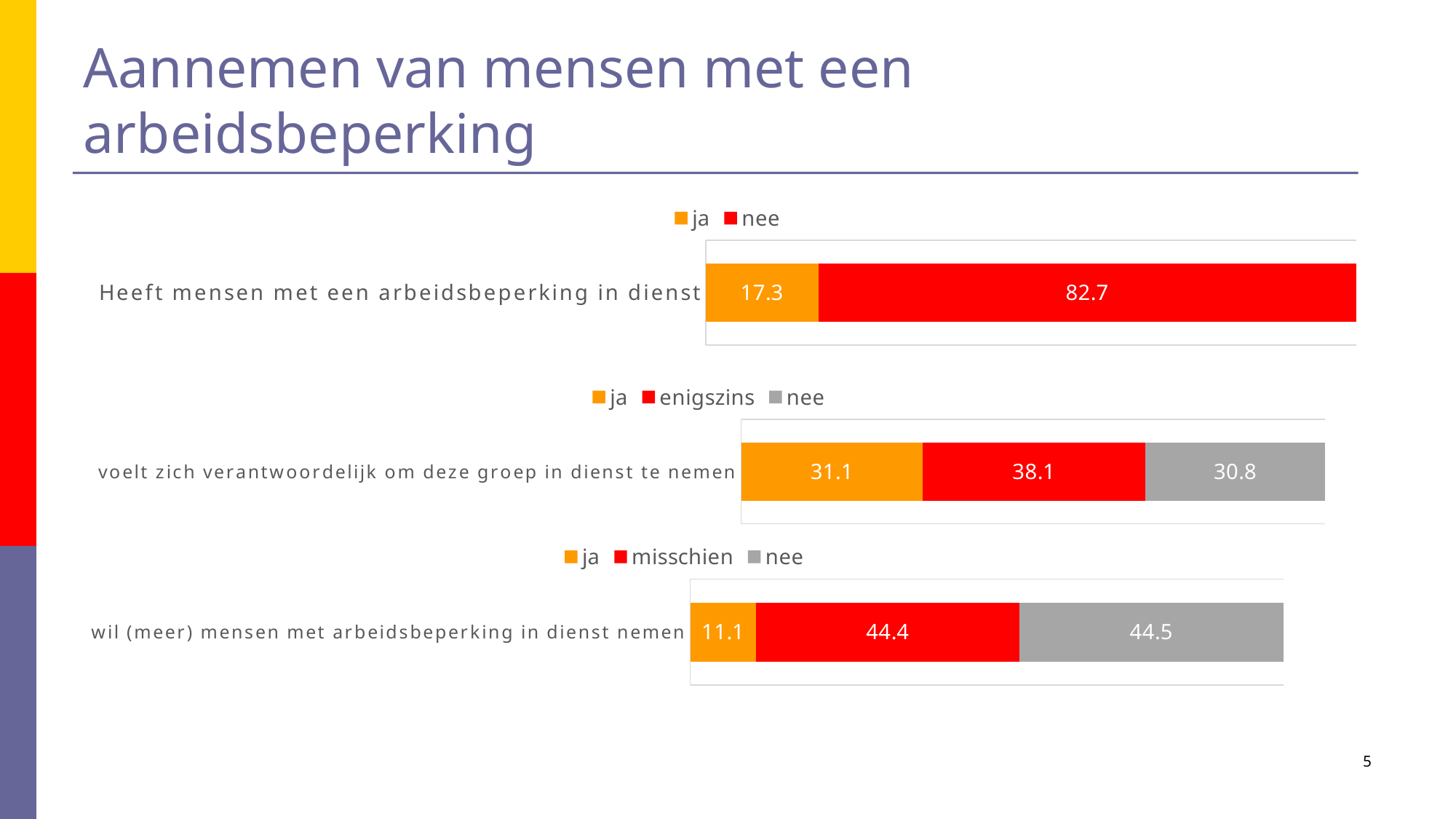
How many series does the legend of the middle chart ("voelt zich verantwoordelijk om deze groep in dienst te nemen") list? 3 In the bottom chart ("wil (meer) mensen met arbeidsbeperking in dienst nemen"), what is the difference between the "misschien" and "ja" values? 33.3 In the top chart ("Heeft mensen met een arbeidsbeperking in dienst"), what is the value for "nee"? 82.7 In the top chart ("Heeft mensen met een arbeidsbeperking in dienst"), what is the value for "ja"? 17.3 In the bottom chart ("wil (meer) mensen met arbeidsbeperking in dienst nemen"), which series has the lowest value? ja In the middle chart ("voelt zich verantwoordelijk om deze groep in dienst te nemen"), which series has the highest value? enigszins In the middle chart ("voelt zich verantwoordelijk om deze groep in dienst te nemen"), what is the value for "enigszins"? 38.1 In the bottom chart ("wil (meer) mensen met arbeidsbeperking in dienst nemen"), what is the value for "misschien"? 44.4 What kind of chart is the top chart ("Heeft mensen met een arbeidsbeperking in dienst")? Stacked bar chart In the top chart ("Heeft mensen met een arbeidsbeperking in dienst"), which is larger, "ja" or "nee"? nee In the top chart ("Heeft mensen met een arbeidsbeperking in dienst"), what is the difference between the "nee" and "ja" values? 65.4 In the bottom chart ("wil (meer) mensen met arbeidsbeperking in dienst nemen"), what is the value for "ja"? 11.1